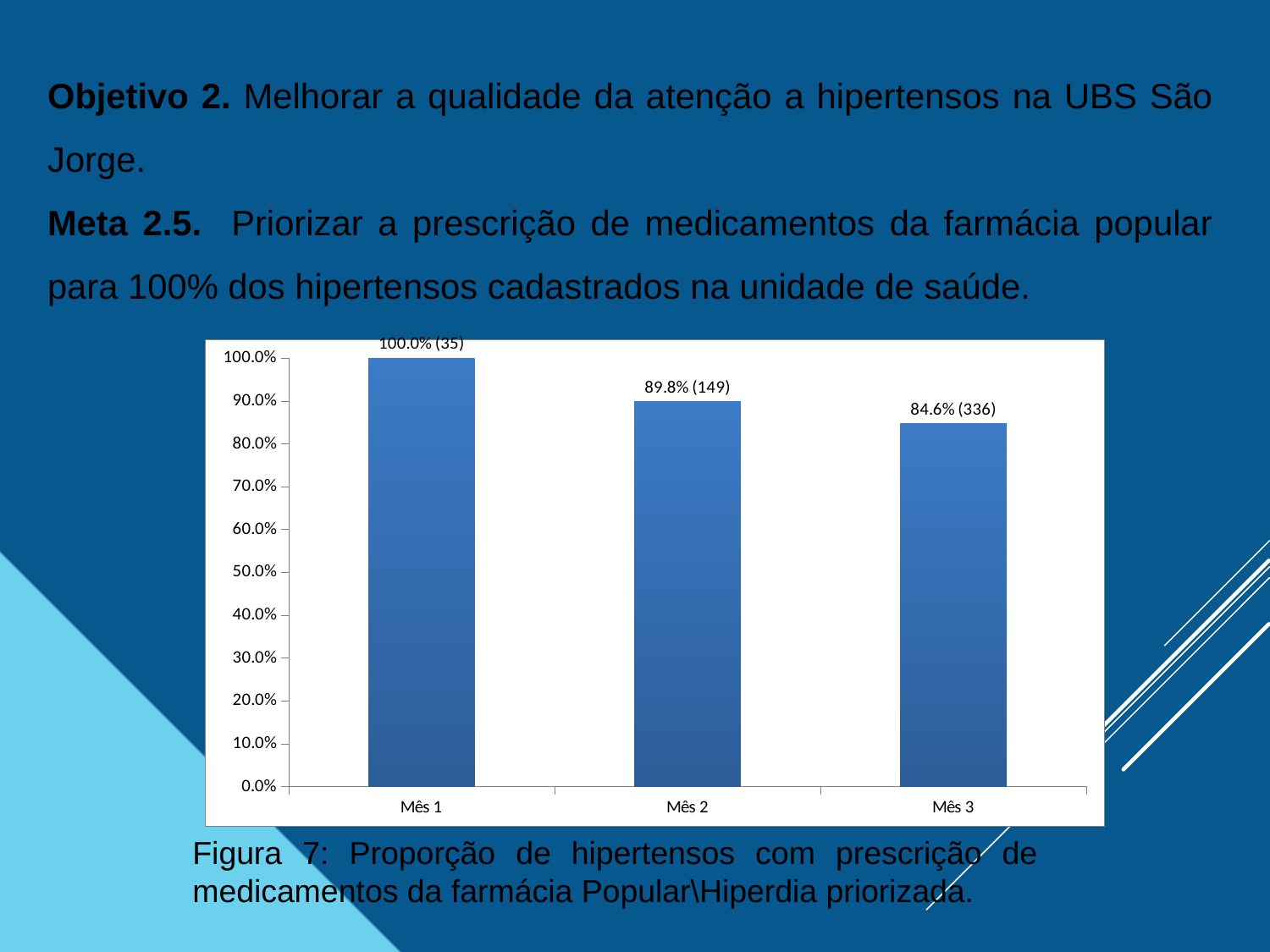
What is the value shown for Mês 1? 100.0% (35) What is the difference in percentage points between Mês 2 and Mês 3? 5.2 What kind of chart is shown on the slide? bar chart What is the value shown for Mês 2? 89.8% (149) Is the value for Mês 3 greater or less than 80.0%? greater What is the difference in percentage points between Mês 1 and Mês 2? 10.2 Do the values rise or fall from Mês 1 to Mês 3? fall Which month has the lowest proportion? Mês 3 Which month has the highest proportion? Mês 1 How many months are shown on the x axis? 3 What is the value shown for Mês 3? 84.6% (336) Which is larger, the proportion for Mês 2 or for Mês 3? Mês 2